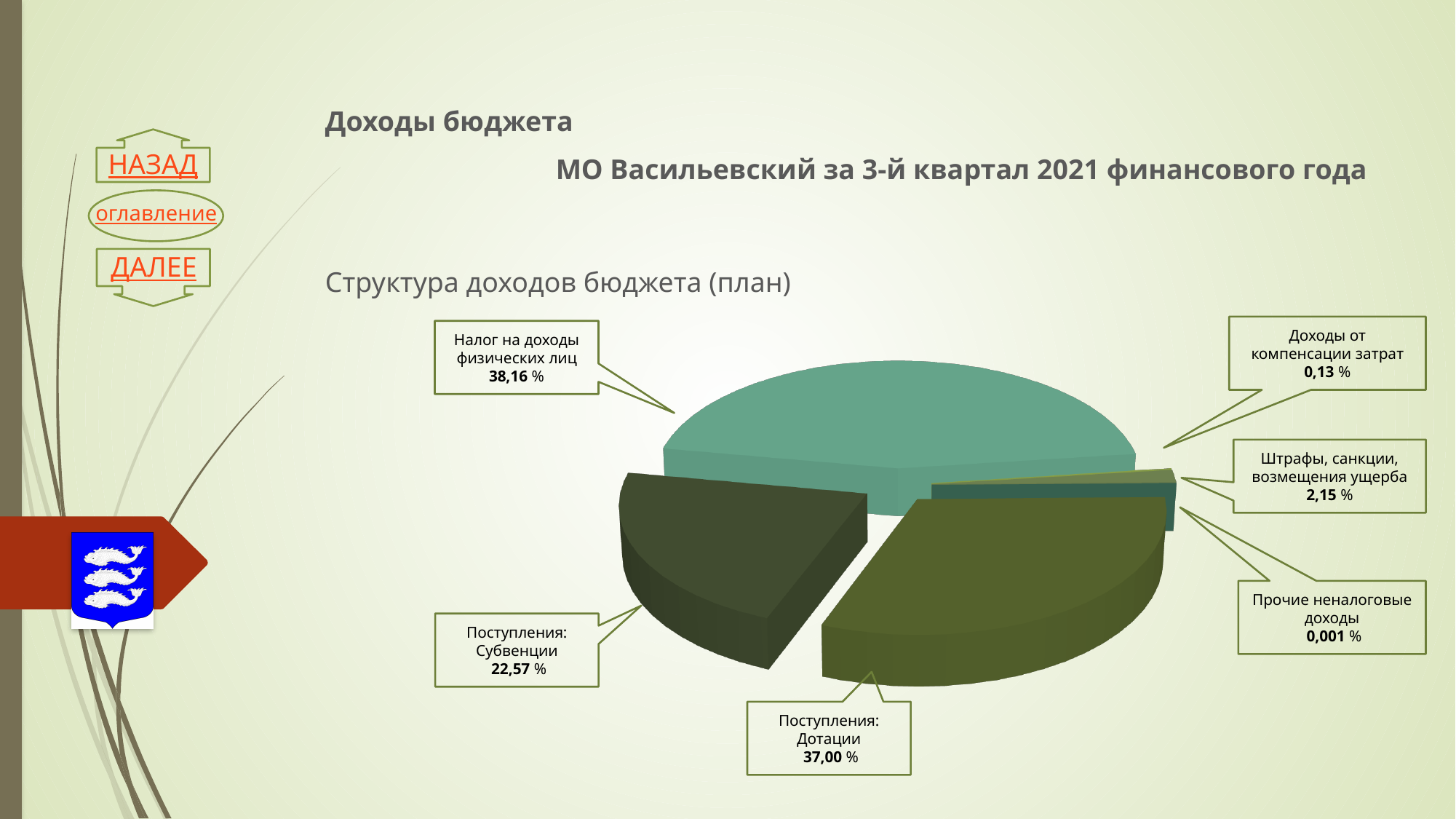
What share of the pie is labelled for Налог на доходы физических лиц? 38,16 % What kind of chart is shown on the slide? Pie chart What share of the pie is labelled for Поступления: Субвенции? 22,57 % Which is larger: the share for Поступления: Дотации or the share for Поступления: Субвенции? Поступления: Дотации How many slices does the pie chart have? 6 What share of the pie is labelled for Поступления: Дотации? 37,00 % What is the difference in percentage points between Налог на доходы физических лиц and Поступления: Субвенции? 15,59 % What share of the pie is labelled for Доходы от компенсации затрат? 0,13 % What is the title of the chart? Структура доходов бюджета (план) What share of the pie is labelled for Штрафы, санкции, возмещения ущерба? 2,15 % Which category has the smallest share of the pie? Прочие неналоговые доходы Which category has the largest share of the pie? Налог на доходы физических лиц